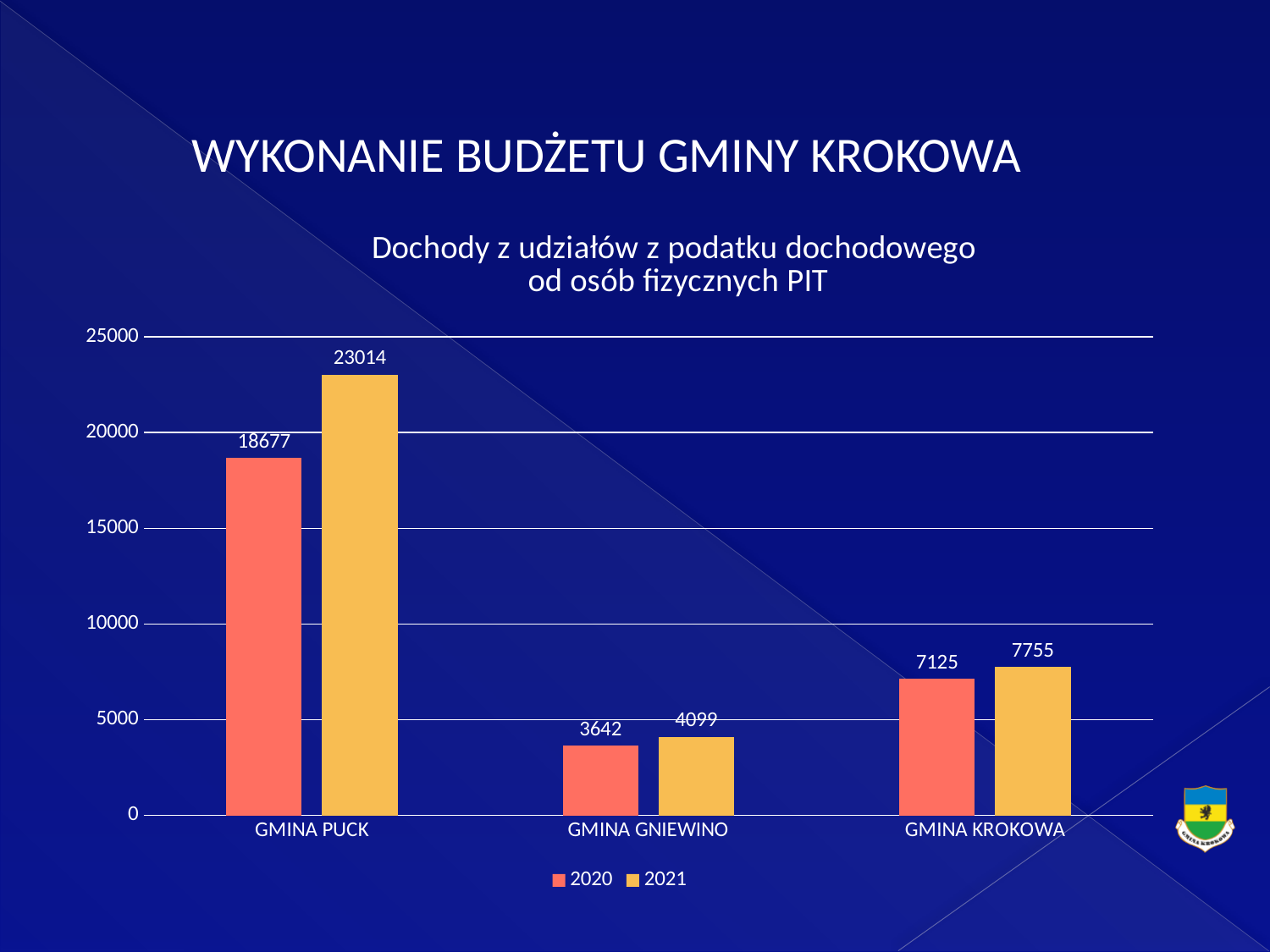
Which category has the highest value in the 2020 series? GMINA PUCK What is the value for GMINA KROKOWA in 2021? 7755 Which is larger: the 2020 value for GMINA KROKOWA or the 2021 value for GMINA GNIEWINO? 2020 value for GMINA KROKOWA Is the 2020 value for GMINA PUCK greater or less than 20000? less What is the value for GMINA GNIEWINO in 2020? 3642 What is the difference between the 2021 and 2020 values for GMINA PUCK? 4337 How many series does the legend list? 2 Which category has the lowest value in the 2021 series? GMINA GNIEWINO What kind of chart is shown on the slide? bar chart What is the difference between the 2021 and 2020 values for GMINA KROKOWA? 630 What is the value for GMINA PUCK in 2021? 23014 How many categories are shown on the x axis? 3